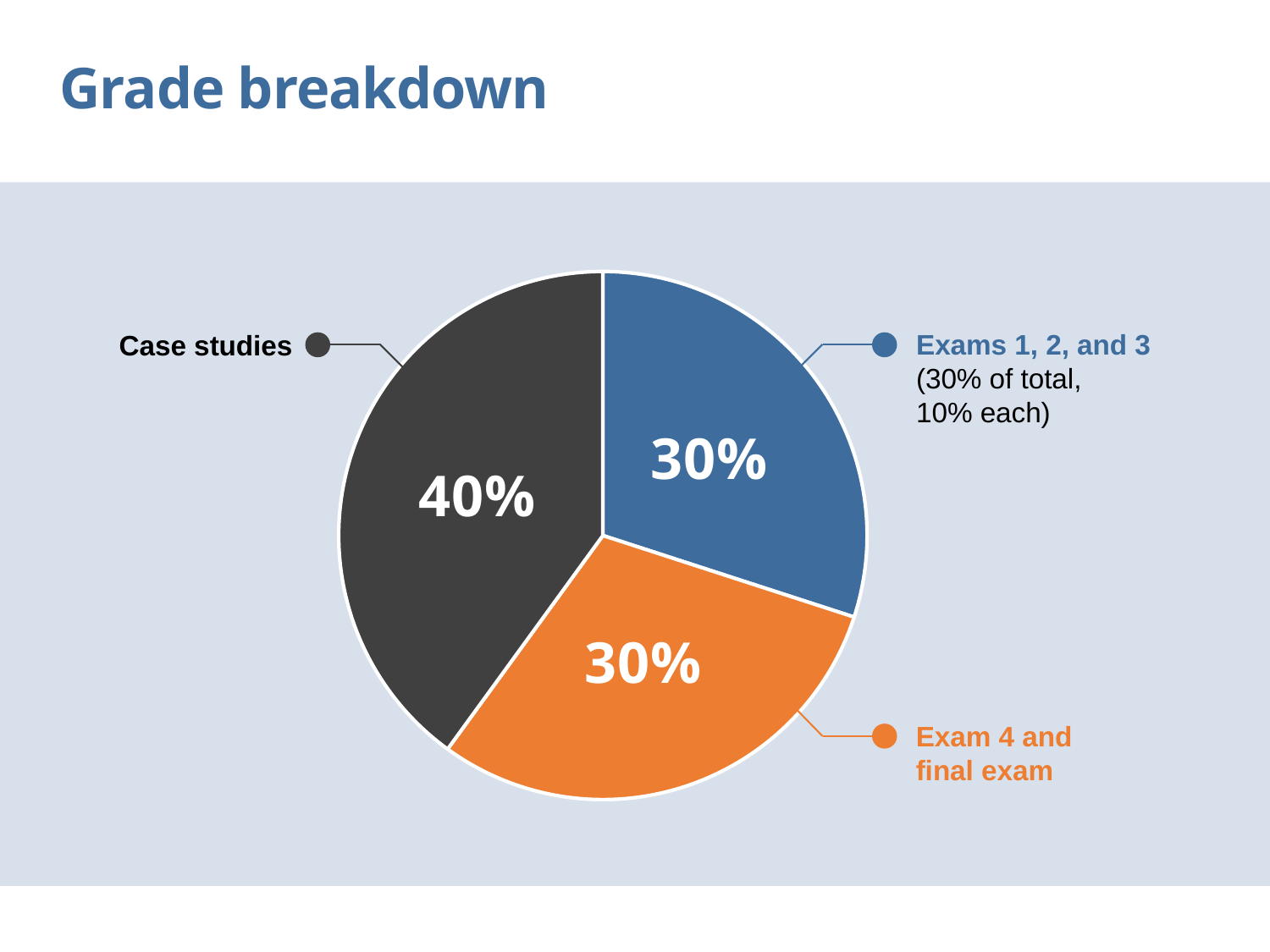
According to the slide, what percentage of the total is each of Exams 1, 2, and 3 worth? 10% each What share of the grade do Exams 1, 2, and 3 account for? 30% What share of the grade do case studies account for? 40% What share of the grade do Exam 4 and the final exam account for? 30% Which is larger: the share for case studies or the share for Exams 1, 2, and 3? Case studies What colour is the slice for Exam 4 and final exam? orange What is the difference between the share for case studies and the share for Exam 4 and final exam? 10% How many slices does the pie chart have? 3 What is the combined share of Exams 1, 2, and 3 and Exam 4 and final exam? 60% What kind of chart is shown on the slide? pie chart What is the title of the slide containing the pie chart? Grade breakdown Which category has the largest slice of the pie? Case studies